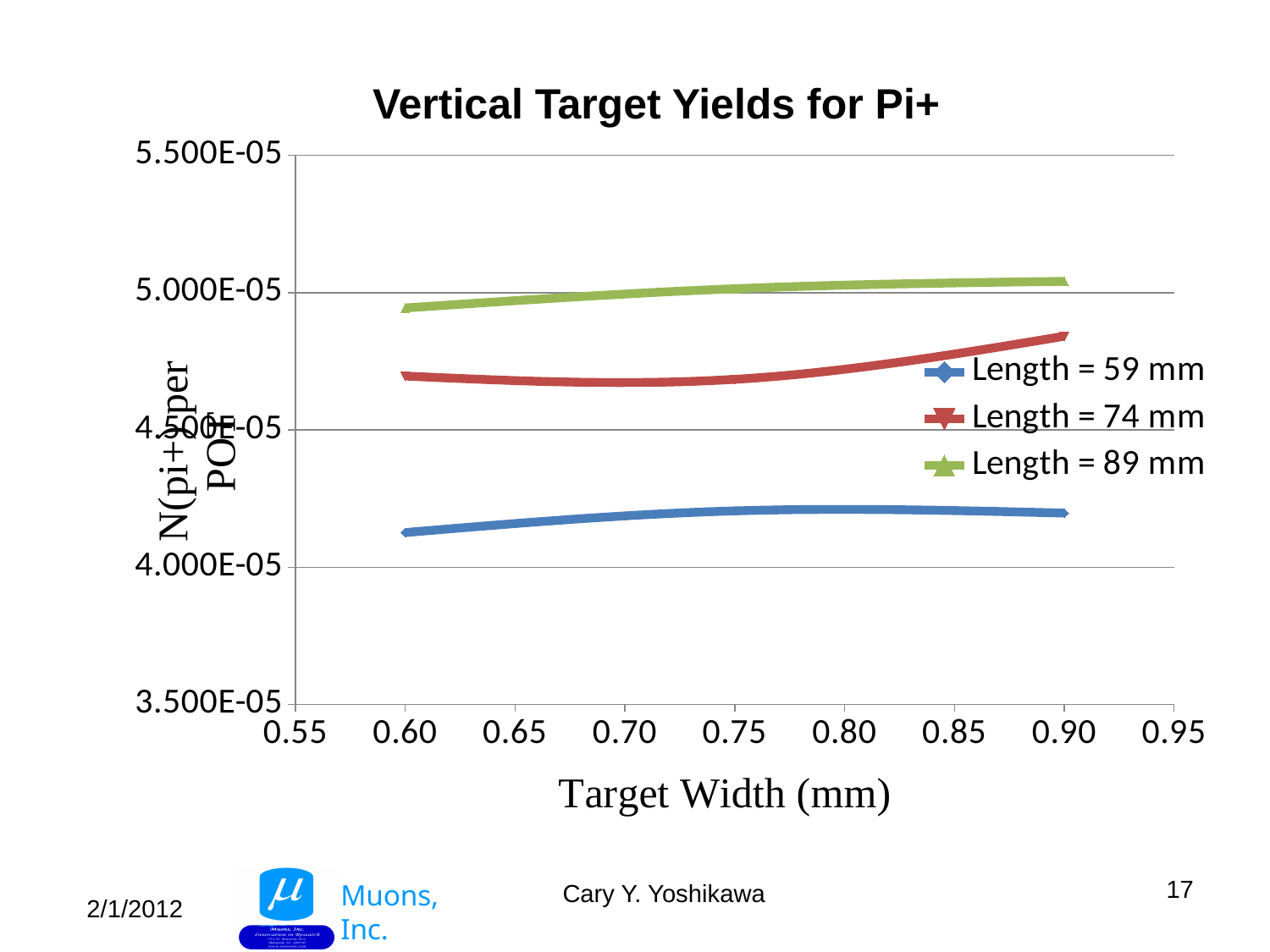
Which series has the highest values across the chart? Length = 89 mm Which series has the lowest values across the chart? Length = 59 mm What kind of chart is shown on the slide? line chart At a target width of 0.60, which is larger: the value for Length = 89 mm or the value for Length = 59 mm? Length = 89 mm Is the value for Length = 74 mm at a target width of 0.60 greater or less than 4.500E-05? greater What is the label of the x axis? Target Width (mm) What is the title of the chart? Vertical Target Yields for Pi+ Is the value for Length = 59 mm at a target width of 0.60 greater or less than 4.500E-05? less Is the value for Length = 89 mm at a target width of 0.60 greater or less than 5.000E-05? less How many series does the legend list? 3 Do the values for Length = 89 mm rise or fall as target width increases from 0.60 to 0.90? rise